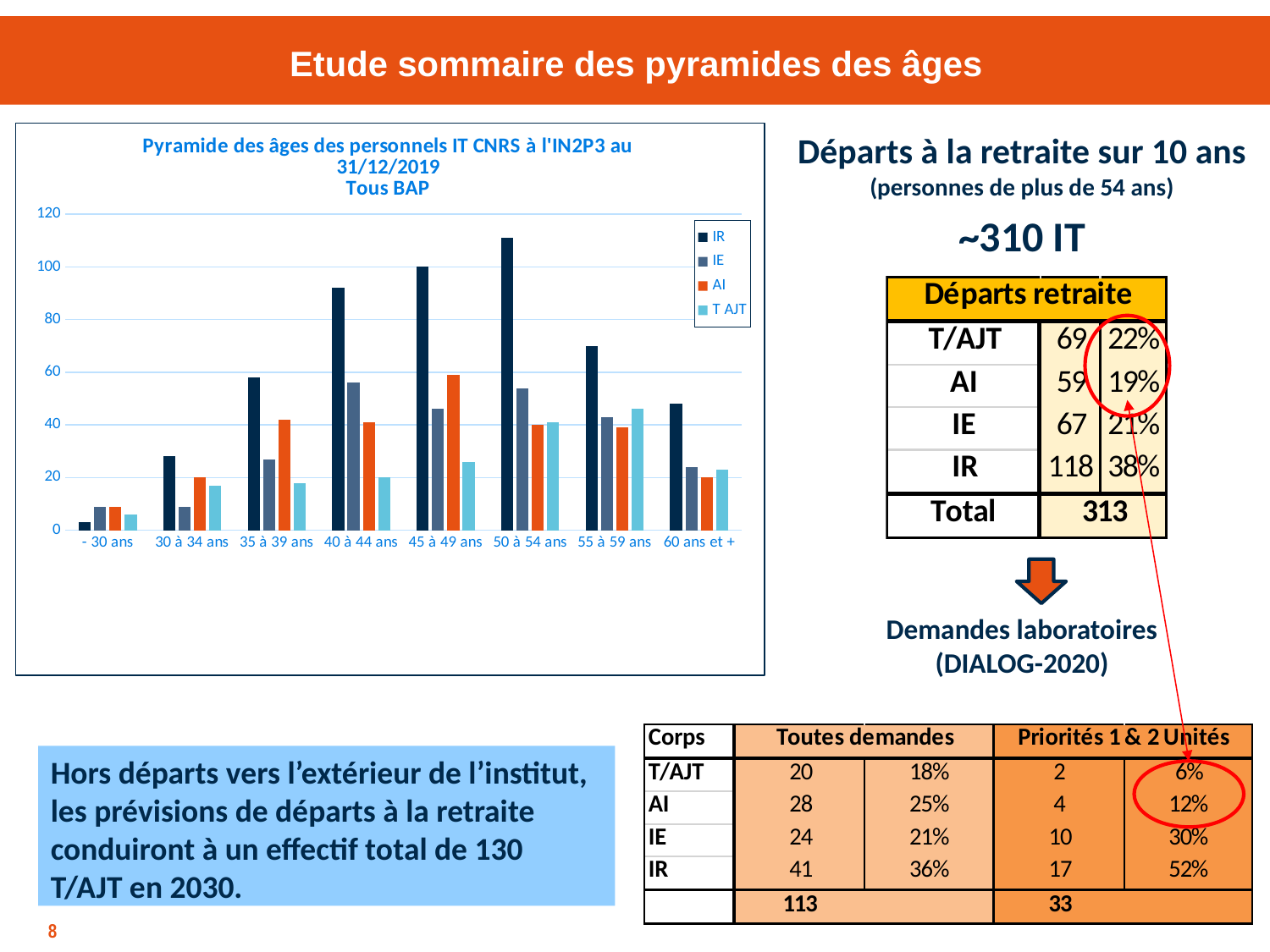
Is the IR value for 40 à 44 ans greater or less than 80? greater In which age group is the IR bar the shortest? - 30 ans Is the IR value for 50 à 54 ans greater or less than 100? greater In the 45 à 49 ans age group, which is larger, the AI bar or the IE bar? AI How many series does the chart legend list? 4 What kind of chart is shown on the slide? bar chart Is the IR value for 60 ans et + greater or less than 60? less What is the title of the chart? Pyramide des âges des personnels IT CNRS à l'IN2P3 au 31/12/2019 Tous BAP In which age group is the IR bar the tallest? 50 à 54 ans Which series are listed in the chart legend? IR, IE, AI, T AJT Does the IR series rise or fall from 30 à 34 ans to 50 à 54 ans? rise How many age groups are shown on the x axis of the chart? 8